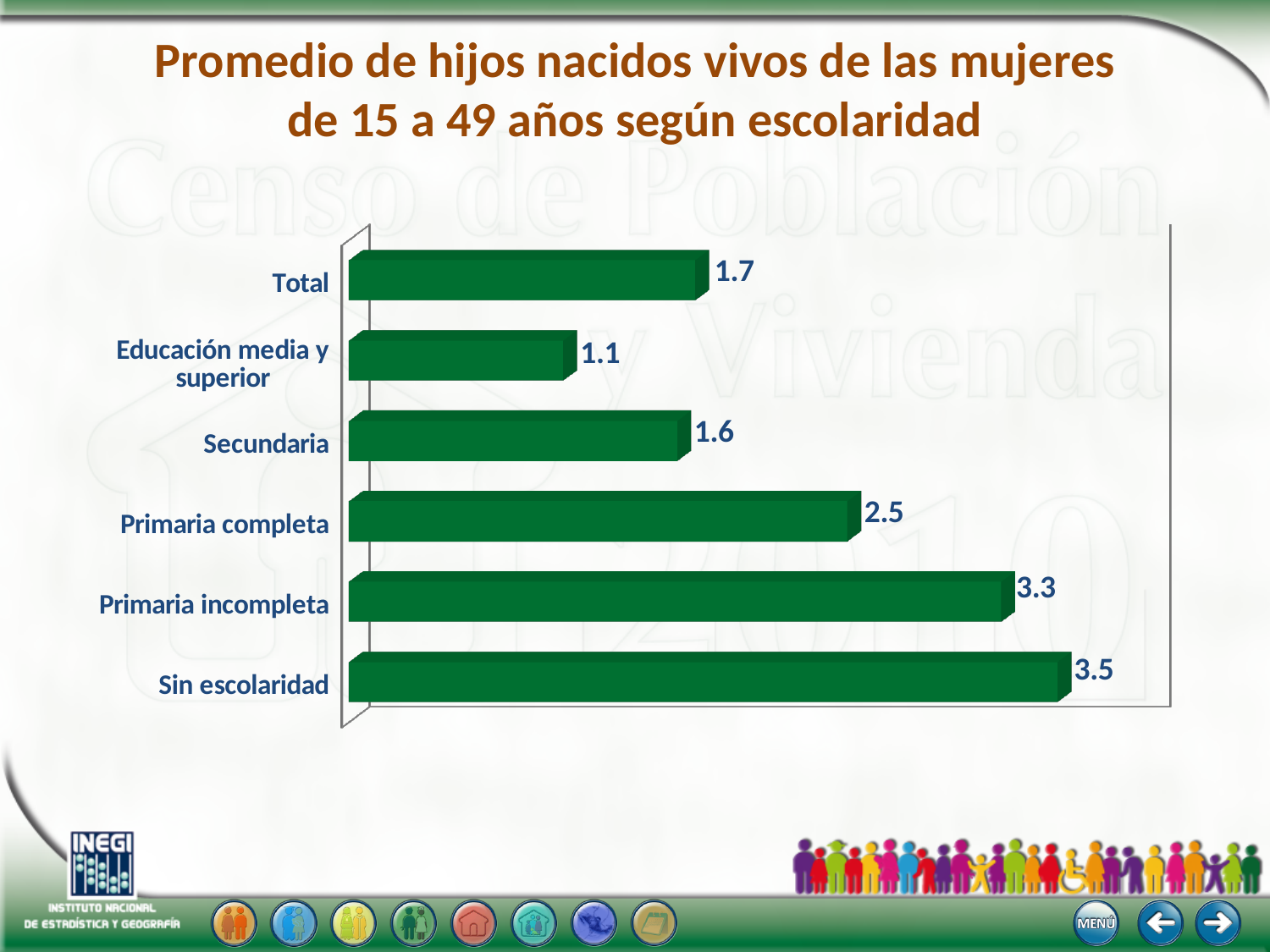
Which category has the lowest value? Educación media y superior What colour are the bars in the chart? Green What type of chart is shown on the slide? Bar chart What is the average number of live-born children for women with 'Sin escolaridad'? 3.5 What is the value shown for the 'Total' bar? 1.7 Which category has the highest value? Sin escolaridad How many bars are shown in the chart? 6 What is the value for 'Primaria completa'? 2.5 What is the difference between the values for 'Primaria incompleta' and 'Secundaria'? 1.7 What is the difference between the 'Sin escolaridad' value and the 'Total' value? 1.8 What value is shown for 'Educación media y superior'? 1.1 Which is larger, the value for 'Secundaria' or the value for 'Primaria completa'? Primaria completa